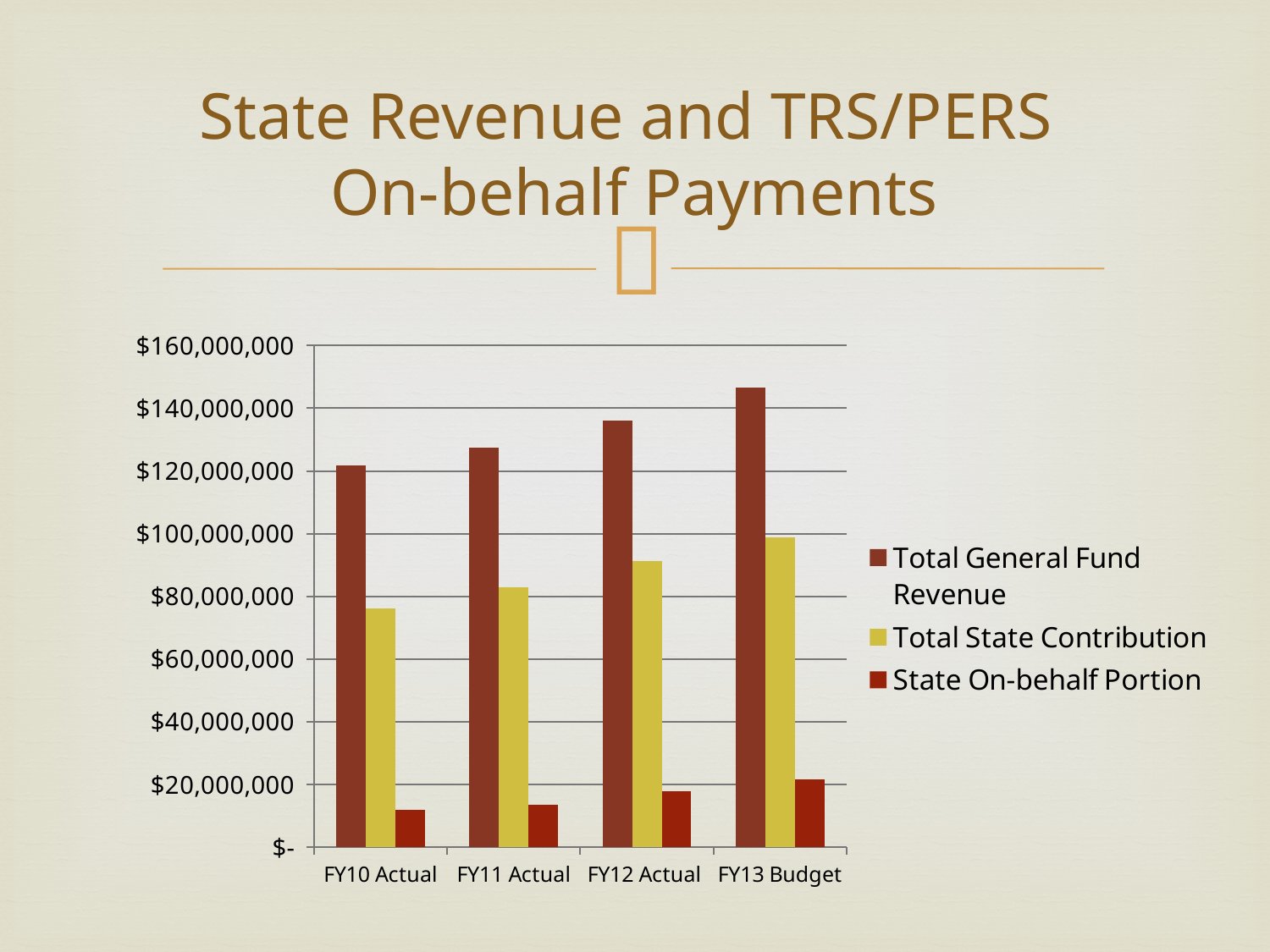
How many series does the legend list? 3 Does Total General Fund Revenue rise or fall from FY10 Actual to FY13 Budget? Rise What kind of chart is shown on the slide? Bar chart Is the Total General Fund Revenue for FY13 Budget greater or less than $140,000,000? greater Is the Total State Contribution for FY12 Actual greater or less than $80,000,000? greater In which category is Total State Contribution lowest? FY10 Actual Is the Total State Contribution for FY10 Actual greater or less than $80,000,000? less How many fiscal year categories are shown on the x axis? 4 In which category is Total General Fund Revenue highest? FY13 Budget Which is larger: Total State Contribution for FY12 Actual or for FY11 Actual? FY12 Actual What colour represents Total State Contribution in the legend? Yellow